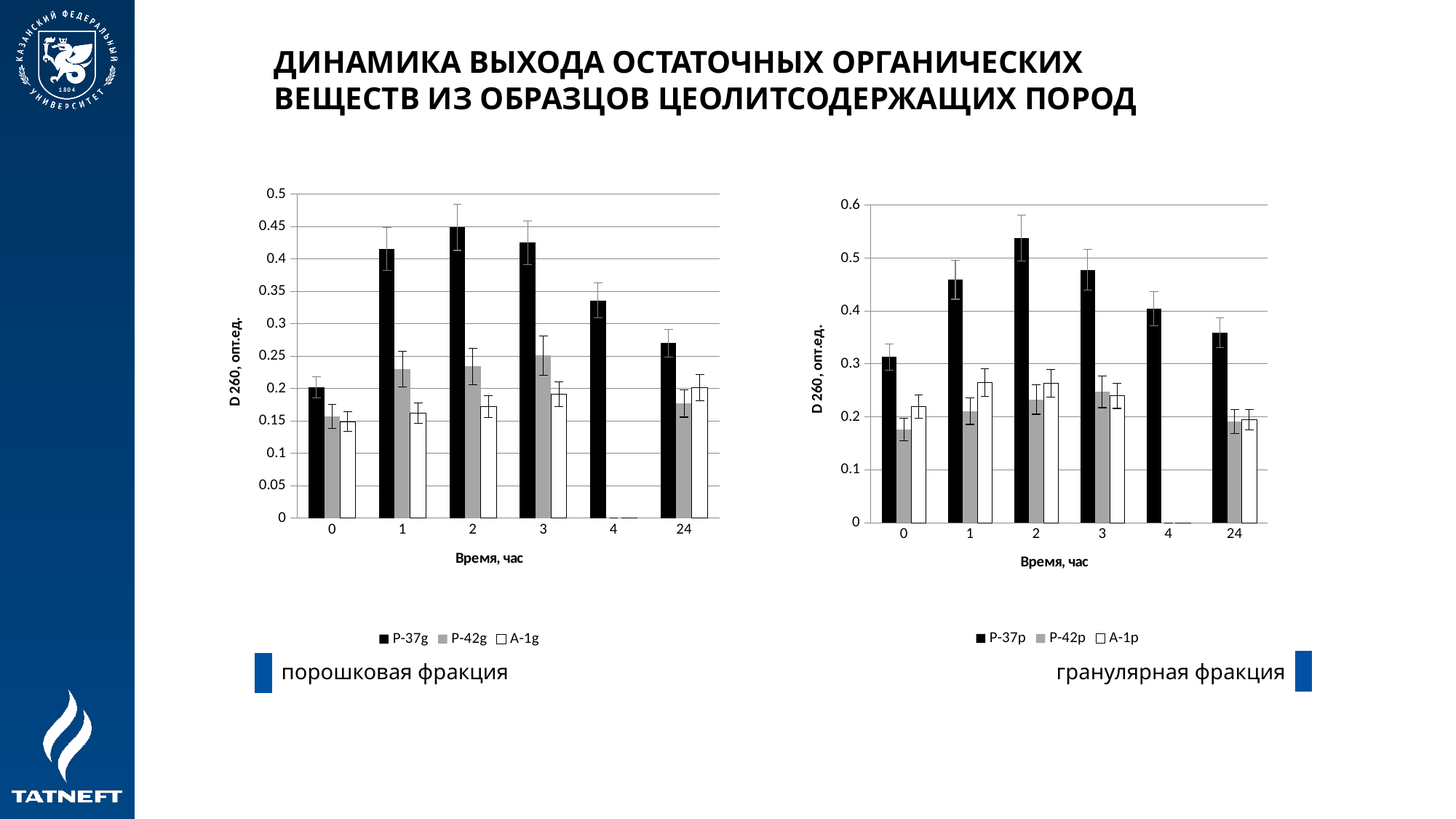
In the right chart (гранулярная фракция), is the value for P-37p at time 0 greater or less than 0.2? greater In the left chart (порошковая фракция), at which time (час) is the P-37g bar highest? 2 In the right chart (гранулярная фракция), which is larger at time 1: P-42p or A-1p? A-1p What kind of chart is the left chart (порошковая фракция)? bar chart What is the y-axis label of the right chart (гранулярная фракция)? D 260, опт.ед. In the right chart (гранулярная фракция), at which time (час) is the P-37p bar highest? 2 In the left chart (порошковая фракция), which is larger at time 1: P-37g or P-42g? P-37g In the left chart (порошковая фракция), is the value for P-37g at time 24 greater or less than 0.25? greater How many series does the legend of the right chart (гранулярная фракция) list? 3 In the right chart (гранулярная фракция), is the value for P-37p at time 24 greater or less than 0.4? less How many time points are shown on the x axis of the left chart (порошковая фракция)? 6 In the left chart (порошковая фракция), do the P-37g values rise or fall from time 2 to time 24? fall